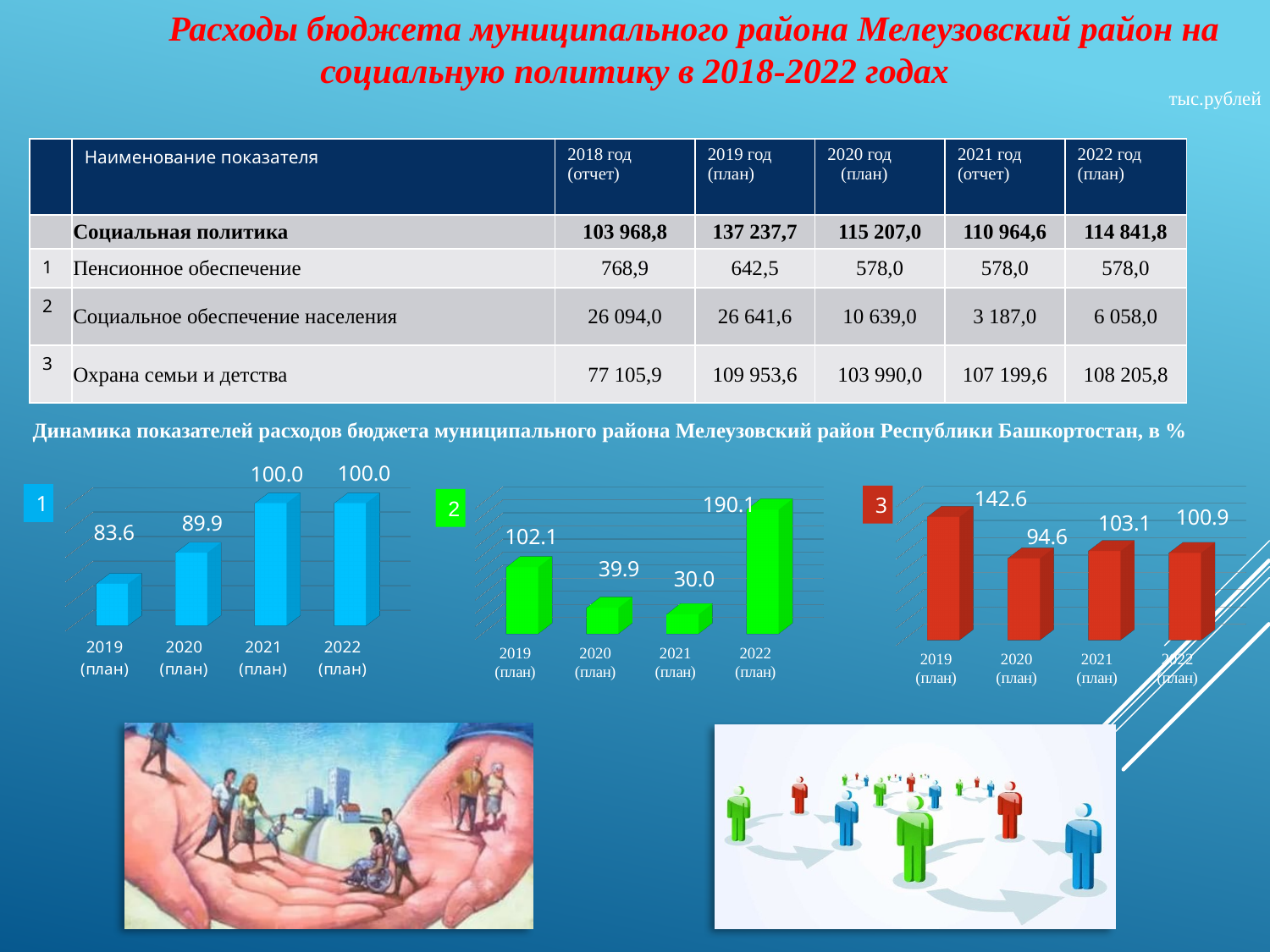
In the red chart labelled 3 (right), which year has the highest value? 2019 (план) In the green chart labelled 2 (middle), what is the value for 2022 (план)? 190.1 In the red chart labelled 3 (right), what is the value for 2021 (план)? 103.1 In the blue chart labelled 1 (left), do the values rise or fall from 2019 (план) to 2021 (план)? rise In the blue chart labelled 1 (left), what is the value for 2020 (план)? 89.9 How many bars does the blue chart labelled 1 (left) have? 4 What colour are the bars in the chart labelled 3 (right)? red In the blue chart labelled 1 (left), what is the value for 2019 (план)? 83.6 In the red chart labelled 3 (right), which is larger: the value for 2020 (план) or the value for 2021 (план)? 2021 (план) What type of chart is the green chart labelled 2 (middle)? bar chart In the green chart labelled 2 (middle), what is the difference between the 2019 (план) and 2020 (план) values? 62.2 In the green chart labelled 2 (middle), which year has the lowest value? 2021 (план)